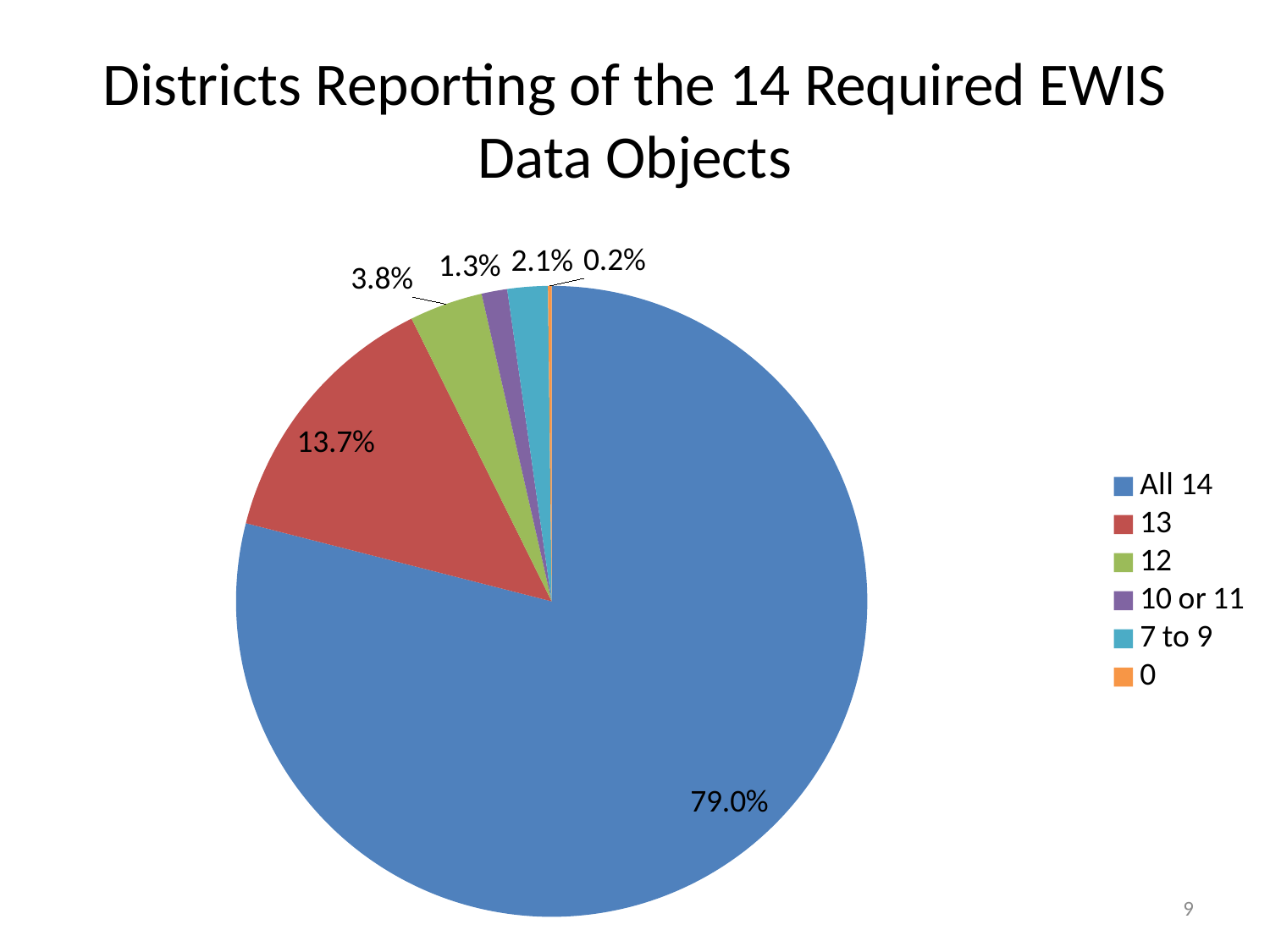
What percentage of districts reported 13 of the required data objects? 13.7% What is the value shown for the '12' slice? 3.8% What percentage of districts reported 0 of the required data objects? 0.2% Which is larger, the '7 to 9' slice or the '10 or 11' slice? 7 to 9 What percentage is shown for the '7 to 9' category? 2.1% What type of chart is shown on the slide? Pie chart Which category has the smallest slice of the pie? 0 How many categories does the legend list? 6 What share of districts reported all 14 required EWIS data objects? 79.0% What is the difference in percentage points between the 'All 14' slice and the '13' slice? 65.3 What is the title of the chart on the slide? Districts Reporting of the 14 Required EWIS Data Objects Which category has the largest slice of the pie? All 14